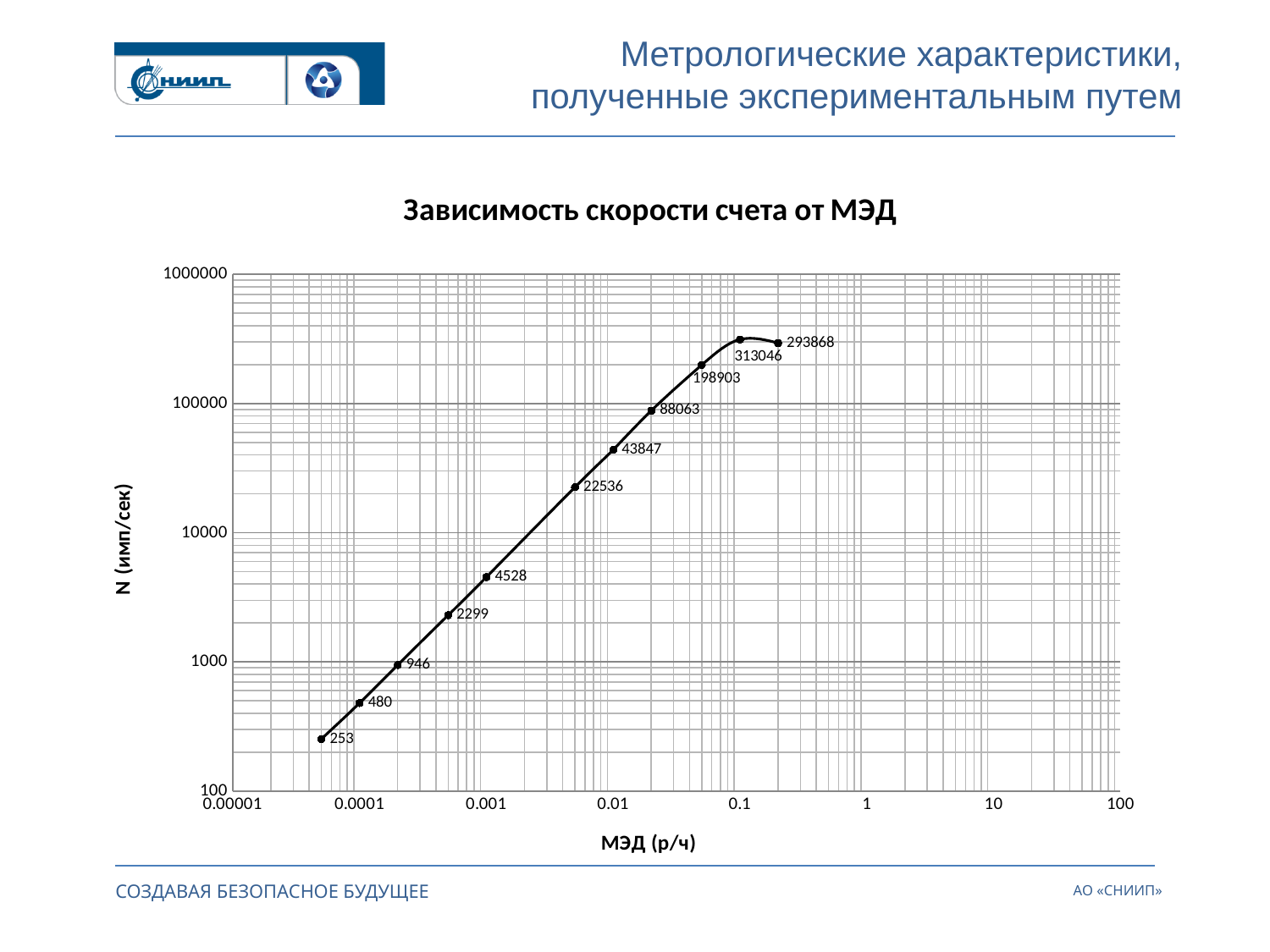
What is the value of N (имп/сек) at МЭД = 0.001 р/ч? 4528 What is the highest labelled value of N (имп/сек) on the chart? 313046 How many data points are plotted on the chart? 11 What is the lowest labelled value of N (имп/сек) on the chart? 253 What is the value of N (имп/сек) at МЭД = 0.0001 р/ч? 480 What is the difference between the labelled values 313046 and 293868 at the right end of the curve? 19178 What is the value of N (имп/сек) at МЭД = 0.1 р/ч? 313046 What kind of chart is shown on the slide? line chart What is the value of N (имп/сек) at МЭД = 0.01 р/ч? 43847 What is the title of the chart? Зависимость скорости счета от МЭД Which is larger: the value at МЭД = 0.1 р/ч or the last point labelled 293868? the value at 0.1 р/ч (313046) What is the label of the vertical axis? N (имп/сек)